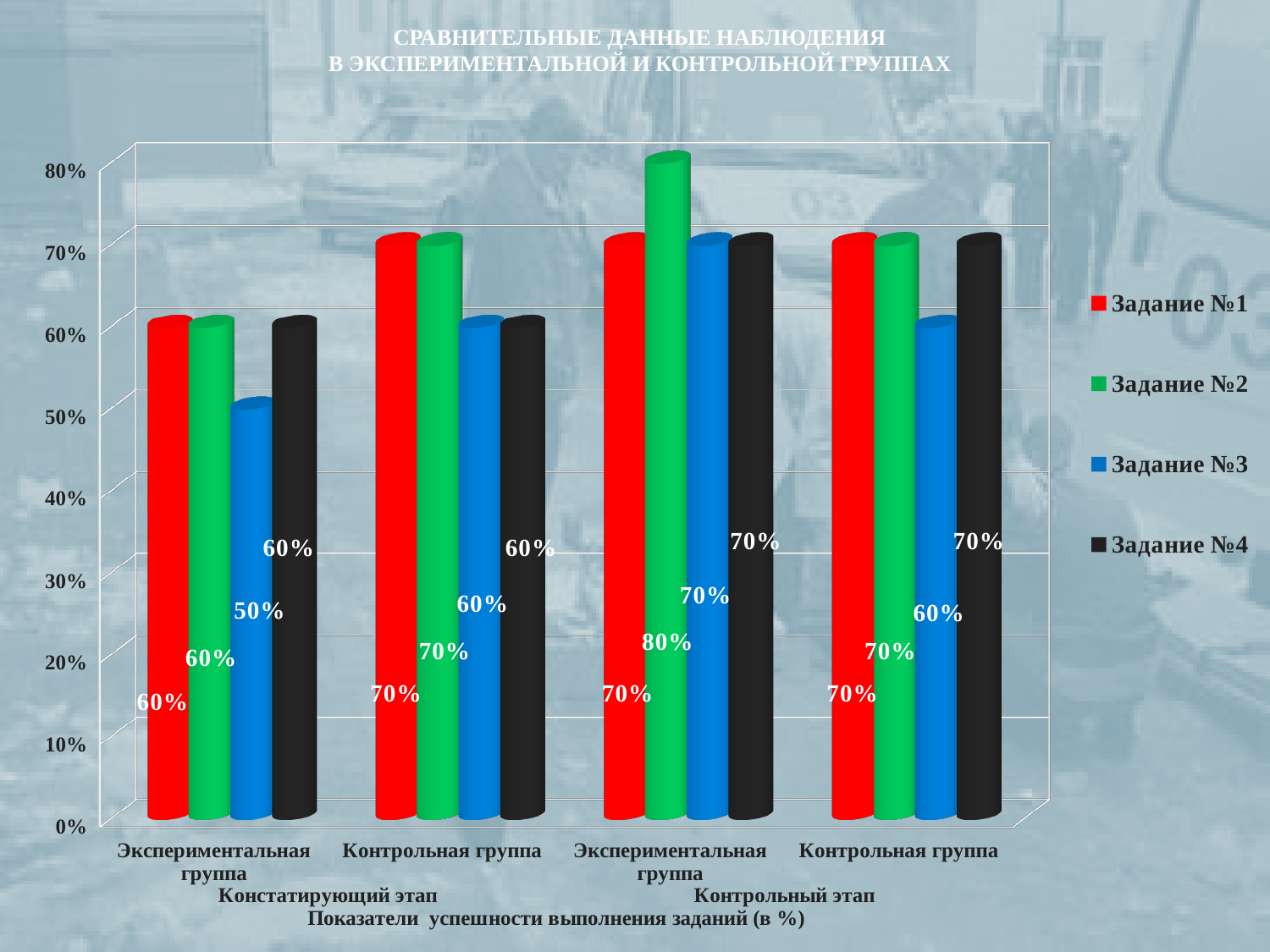
What colour represents Задание №2 in the legend? green Is the value of Задание №1 for the Контрольная группа at the Констатирующий этап greater or less than 60%? greater What is the value of Задание №2 for the Экспериментальная группа at the Контрольный этап? 80% Which series has the lowest value for the Экспериментальная группа at the Констатирующий этап? Задание №3 What is the value of Задание №4 for the Контрольная группа at the Констатирующий этап? 60% Which is larger: Задание №3 for the Контрольная группа at the Контрольный этап or Задание №4 for the same group and stage? Задание №4 What is the value of Задание №3 for the Экспериментальная группа at the Констатирующий этап? 50% How many category groups are plotted along the x axis? 4 What is the difference between the Задание №2 value for the Экспериментальная группа at the Контрольный этап and at the Констатирующий этап? 20% How many series does the legend list? 4 Which series has the highest value for the Экспериментальная группа at the Контрольный этап? Задание №2 What type of chart is shown on the slide? bar chart